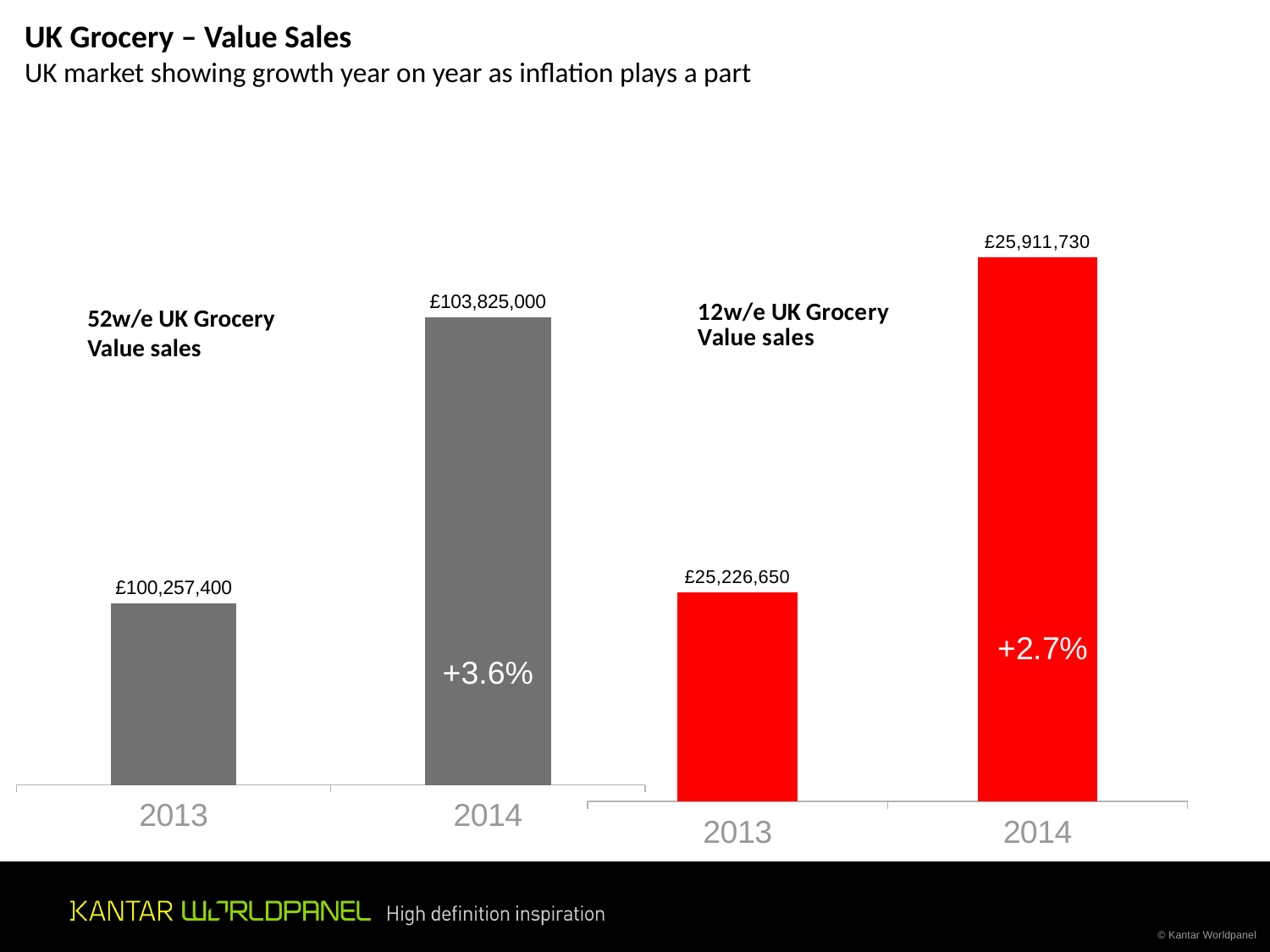
In the 52w/e UK Grocery Value sales chart, what is the value for 2013? £100,257,400 In the 12w/e UK Grocery Value sales chart, what is the difference between the 2014 and 2013 values? £685,080 In the 12w/e UK Grocery Value sales chart, what percentage growth is printed on the 2014 bar? +2.7% In the 12w/e UK Grocery Value sales chart, what is the value for 2013? £25,226,650 In the 12w/e UK Grocery Value sales chart, which year has the lower value? 2013 In the 52w/e UK Grocery Value sales chart, what is the value for 2014? £103,825,000 In the 52w/e UK Grocery Value sales chart, what is the difference between the 2014 and 2013 values? £3,567,600 How many categories are shown on the x axis of the 52w/e UK Grocery Value sales chart? 2 In the 12w/e UK Grocery Value sales chart, what is the value for 2014? £25,911,730 In the 52w/e UK Grocery Value sales chart, what percentage growth is printed on the 2014 bar? +3.6% What kind of chart is the 12w/e UK Grocery Value sales chart? Bar chart In the 52w/e UK Grocery Value sales chart, which year has the higher value? 2014